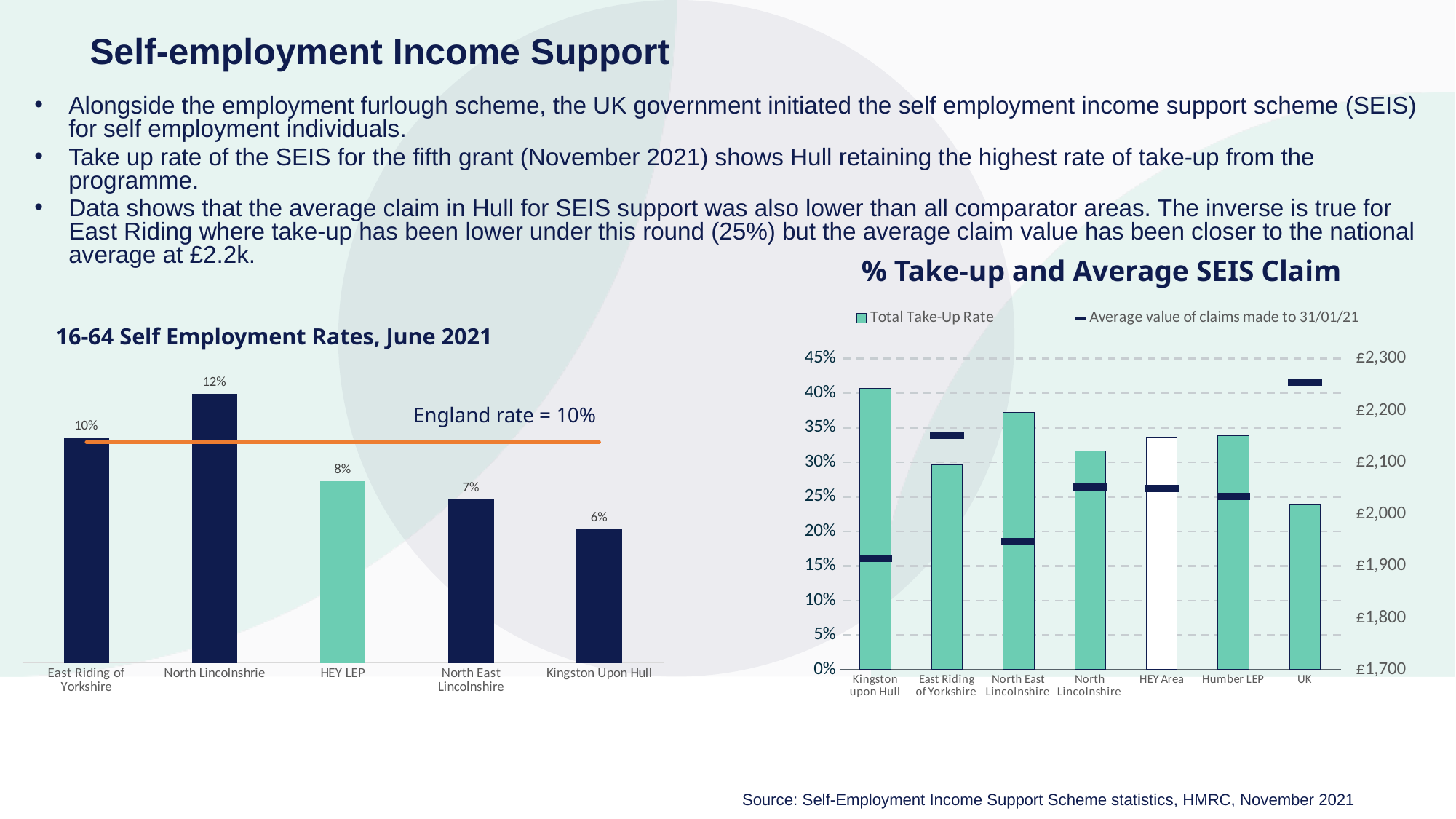
In the '16-64 Self Employment Rates, June 2021' chart, what is the value for Kingston Upon Hull? 6% In the '16-64 Self Employment Rates, June 2021' chart, how many areas are plotted? 5 In the '16-64 Self Employment Rates, June 2021' chart, which area has the highest rate? North Lincolnshire In the '16-64 Self Employment Rates, June 2021' chart, what England rate is marked by the horizontal line? 10% In the '16-64 Self Employment Rates, June 2021' chart, what is the value for North Lincolnshire? 12% In the '% Take-up and Average SEIS Claim' chart, how many series does the legend list? 2 In the '% Take-up and Average SEIS Claim' chart, is the Total Take-Up Rate for East Riding of Yorkshire greater or less than 35%? less In the '% Take-up and Average SEIS Claim' chart, which area has the highest Total Take-Up Rate? Kingston upon Hull In the '16-64 Self Employment Rates, June 2021' chart, which area has the lowest rate? Kingston Upon Hull In the '16-64 Self Employment Rates, June 2021' chart, which is larger, the value for HEY LEP or for North East Lincolnshire? HEY LEP In the '% Take-up and Average SEIS Claim' chart, which area has the lowest Total Take-Up Rate? UK In the '16-64 Self Employment Rates, June 2021' chart, what is the difference between North Lincolnshire and Kingston Upon Hull? 6%